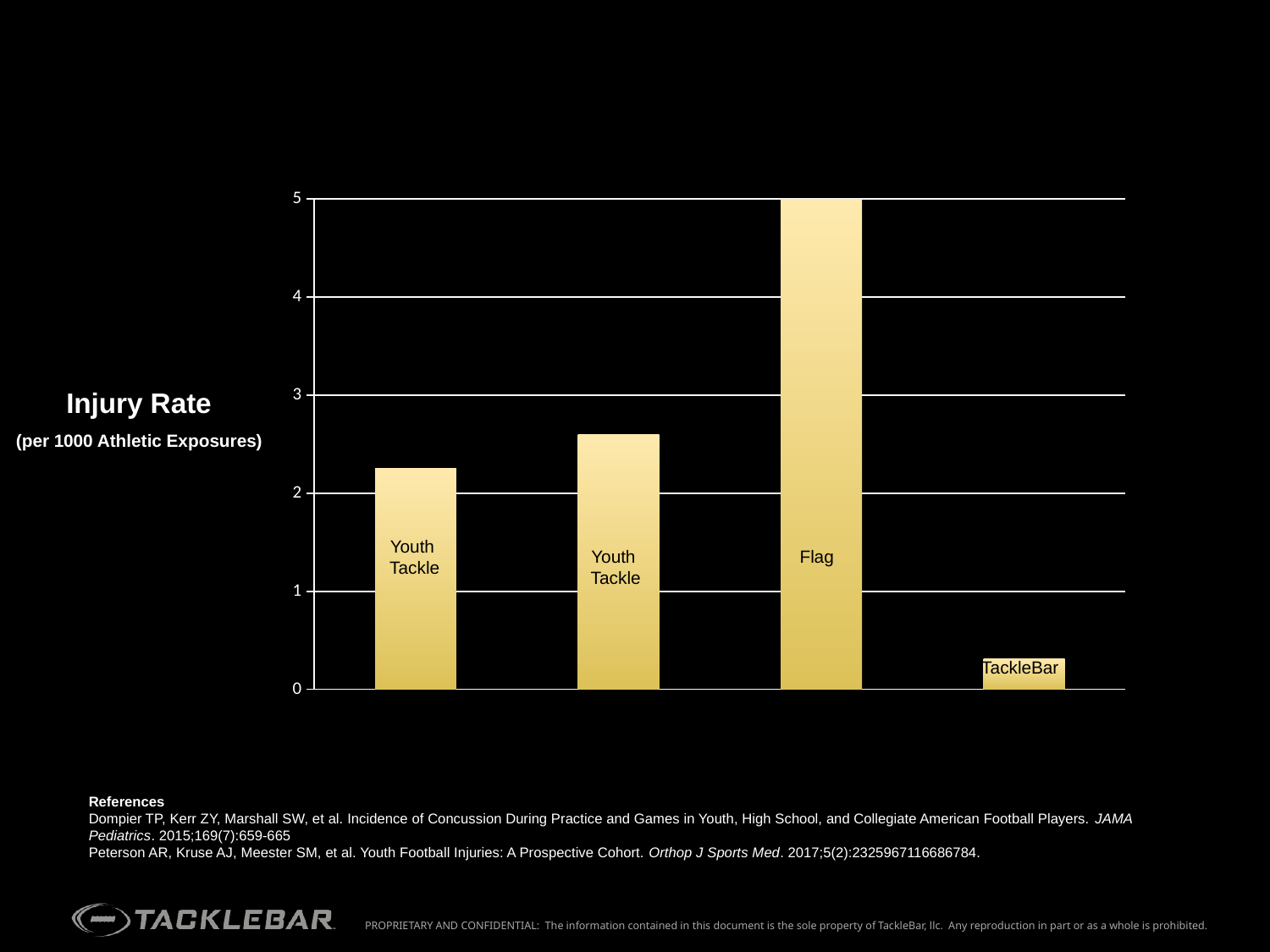
What is the highest value shown on the vertical axis? 5 Is the value for the second Youth Tackle bar (second from the left) greater or less than 3? less Which bar has the lowest injury rate? TackleBar Is the value for TackleBar greater or less than 1? less What kind of chart is shown on the slide? bar chart Which of the two Youth Tackle bars is taller, the first from the left or the second from the left? the second from the left Which bar has the highest injury rate? Flag How many bars are plotted in the chart? 4 Is the value for the leftmost Youth Tackle bar greater or less than 2? greater Which has a higher injury rate, Flag or TackleBar? Flag What quantity does the chart measure, according to the label to the left of the chart? Injury Rate (per 1000 Athletic Exposures)